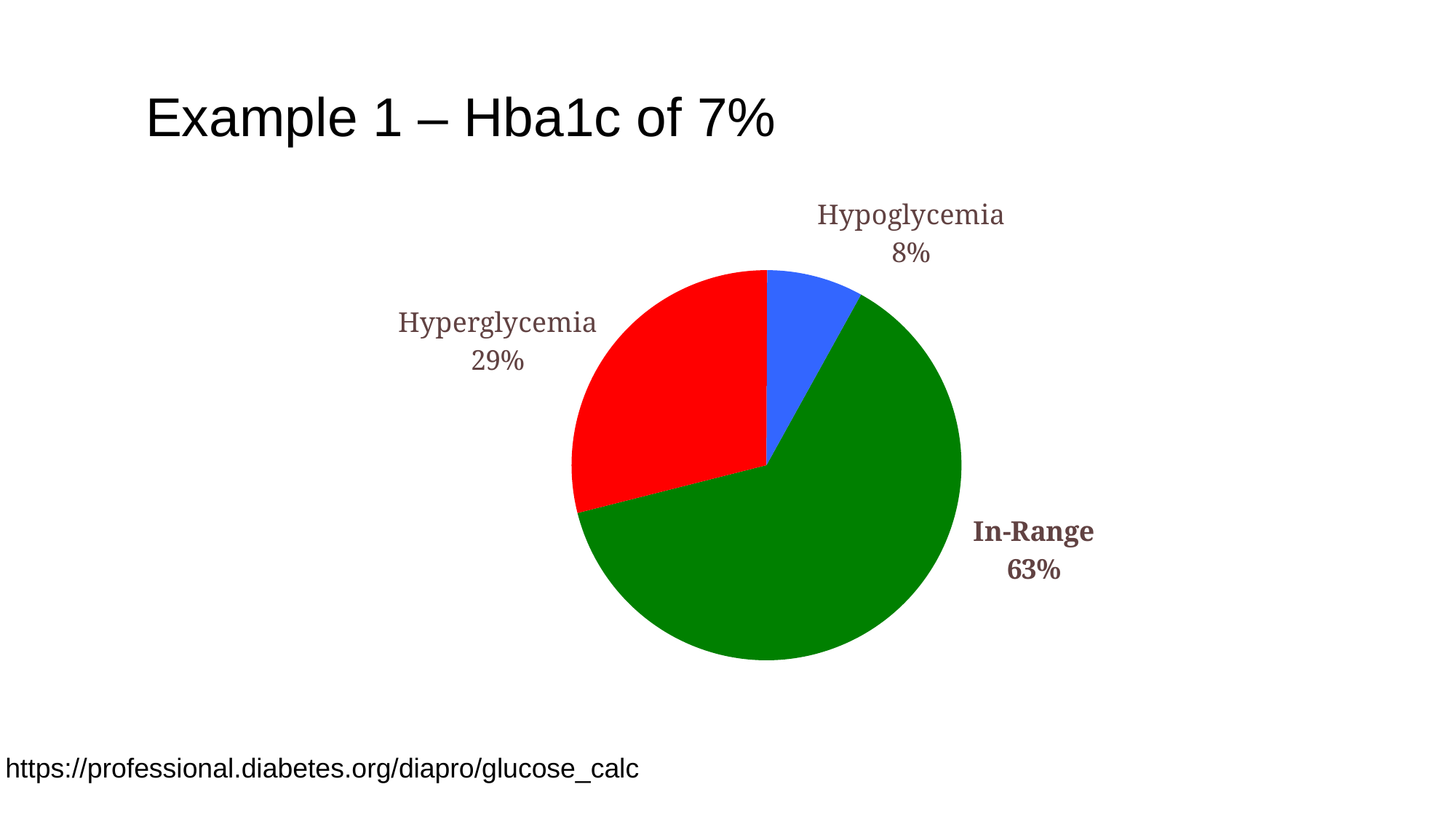
What percentage of the pie is In-Range? 63% What kind of chart is shown on the slide? pie chart Which slice of the pie is the smallest? Hypoglycemia What is the title of the slide containing the pie chart? Example 1 – Hba1c of 7% Which slice of the pie is the largest? In-Range What is the difference in percentage points between the Hyperglycemia and Hypoglycemia slices? 21 What percentage of the pie is Hyperglycemia? 29% How many slices does the pie chart have? 3 Which is larger, the Hyperglycemia slice or the Hypoglycemia slice? Hyperglycemia What is the difference in percentage points between the In-Range and Hyperglycemia slices? 34 What percentage of the pie is Hypoglycemia? 8% What colour is the In-Range slice? green